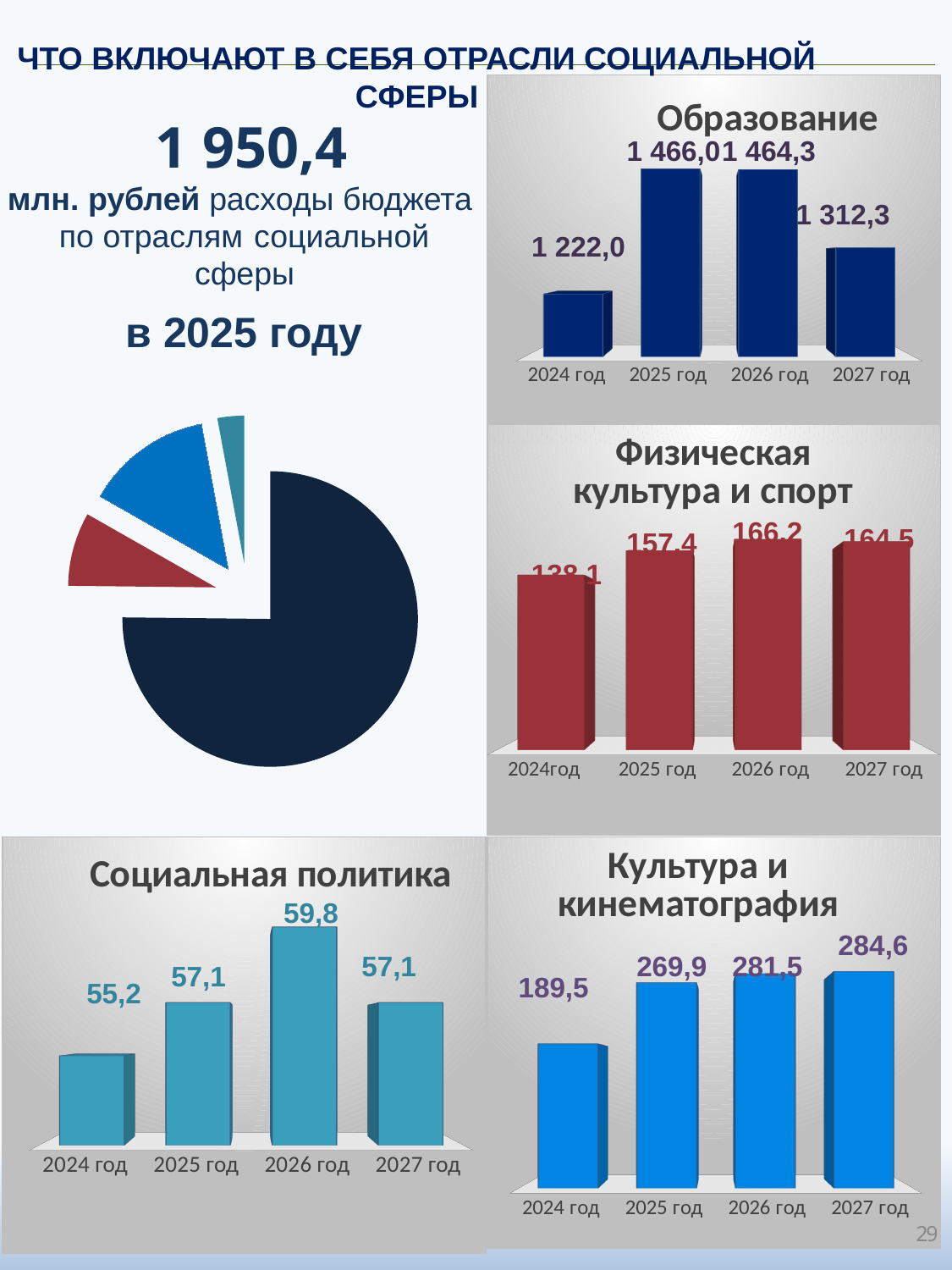
In the 'Культура и кинематография' chart, what is the value for 2024 год? 189,5 In the 'Образование' chart, what is the value for 2027 год? 1 312,3 In the 'Образование' chart, what is the value for 2024 год? 1 222,0 In the 'Культура и кинематография' chart, do the values rise or fall from 2024 год to 2027 год? rise In the 'Физическая культура и спорт' chart, what is the value for 2025 год? 157,4 In the 'Образование' chart, which year has the lowest value? 2024 год In the 'Социальная политика' chart, what is the difference between the 2026 год and 2024 год values? 4,6 What kind of chart is shown on the left side of the slide below the '1 950,4' figure? pie chart In the 'Социальная политика' chart, how many bars are plotted? 4 In the 'Культура и кинематография' chart, is the value for 2025 год larger or smaller than the value for 2024 год? larger In the 'Социальная политика' chart, which year has the highest value? 2026 год In the 'Физическая культура и спорт' chart, which year has the lowest value? 2024год